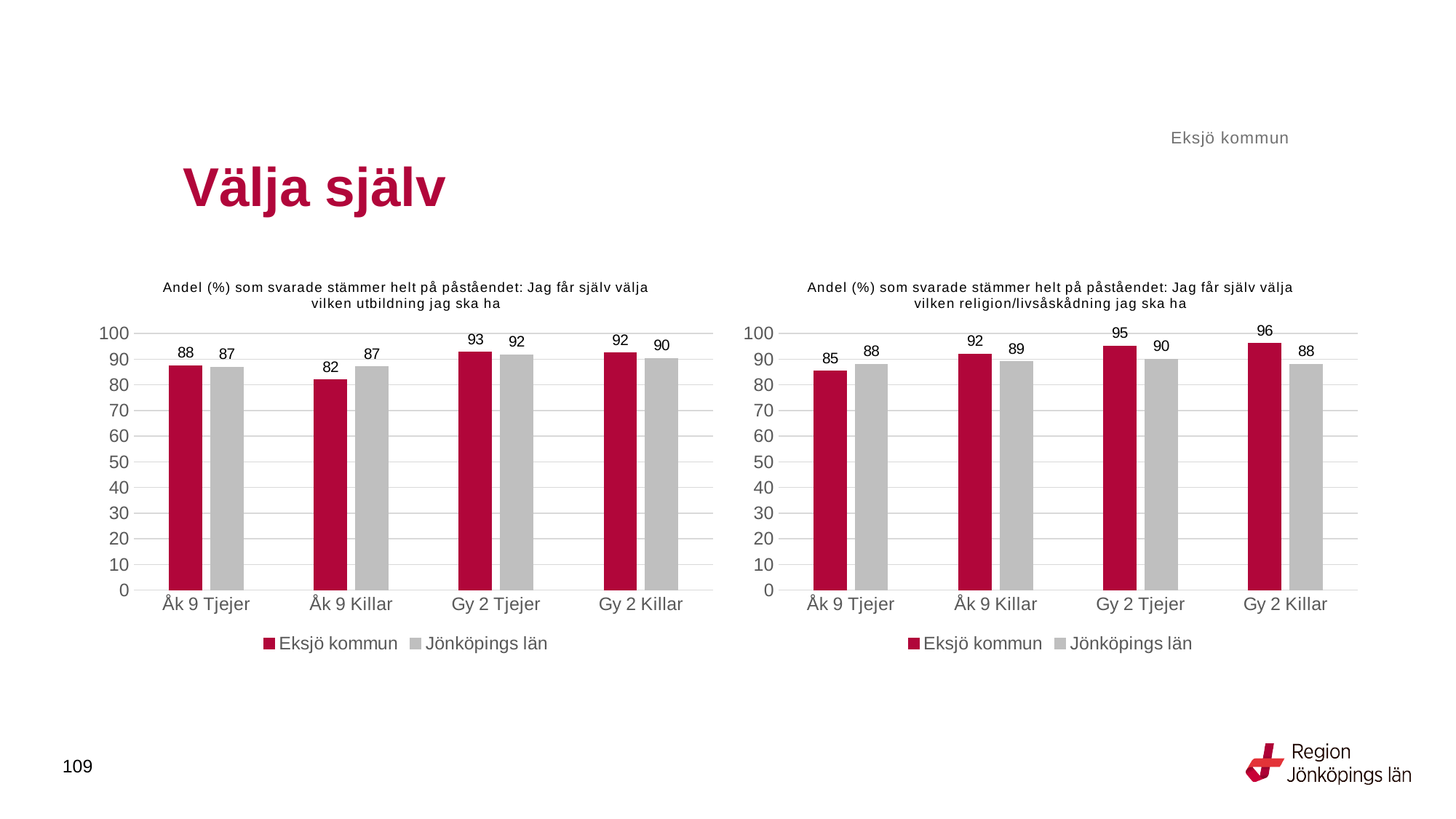
What kind of chart is the left chart (about choosing education)? Bar chart In the right chart (about choosing religion/livsåskådning), what is the difference between the Eksjö kommun value and the Jönköpings län value for Gy 2 Killar? 8 In the right chart (about choosing religion/livsåskådning), do the Eksjö kommun values rise or fall from Åk 9 Tjejer to Gy 2 Killar? Rise In the left chart (about choosing education), is the Eksjö kommun value for Åk 9 Killar greater or less than 90? less How many series does the legend of the left chart (about choosing education) list? 2 In the right chart (about choosing religion/livsåskådning), which category has the lowest Eksjö kommun value? Åk 9 Tjejer In the left chart (about choosing education), what is the value for Eksjö kommun for Åk 9 Killar? 82 In the right chart (about choosing religion/livsåskådning), which is larger for Åk 9 Tjejer: Eksjö kommun or Jönköpings län? Jönköpings län In the left chart (about choosing education), which category has the highest Eksjö kommun value? Gy 2 Tjejer How many categories are shown on the x axis of the right chart (about choosing religion/livsåskådning)? 4 In the left chart (about choosing education), what is the difference between the Jönköpings län value and the Eksjö kommun value for Åk 9 Killar? 5 In the right chart (about choosing religion/livsåskådning), what is the value for Jönköpings län for Gy 2 Tjejer? 90